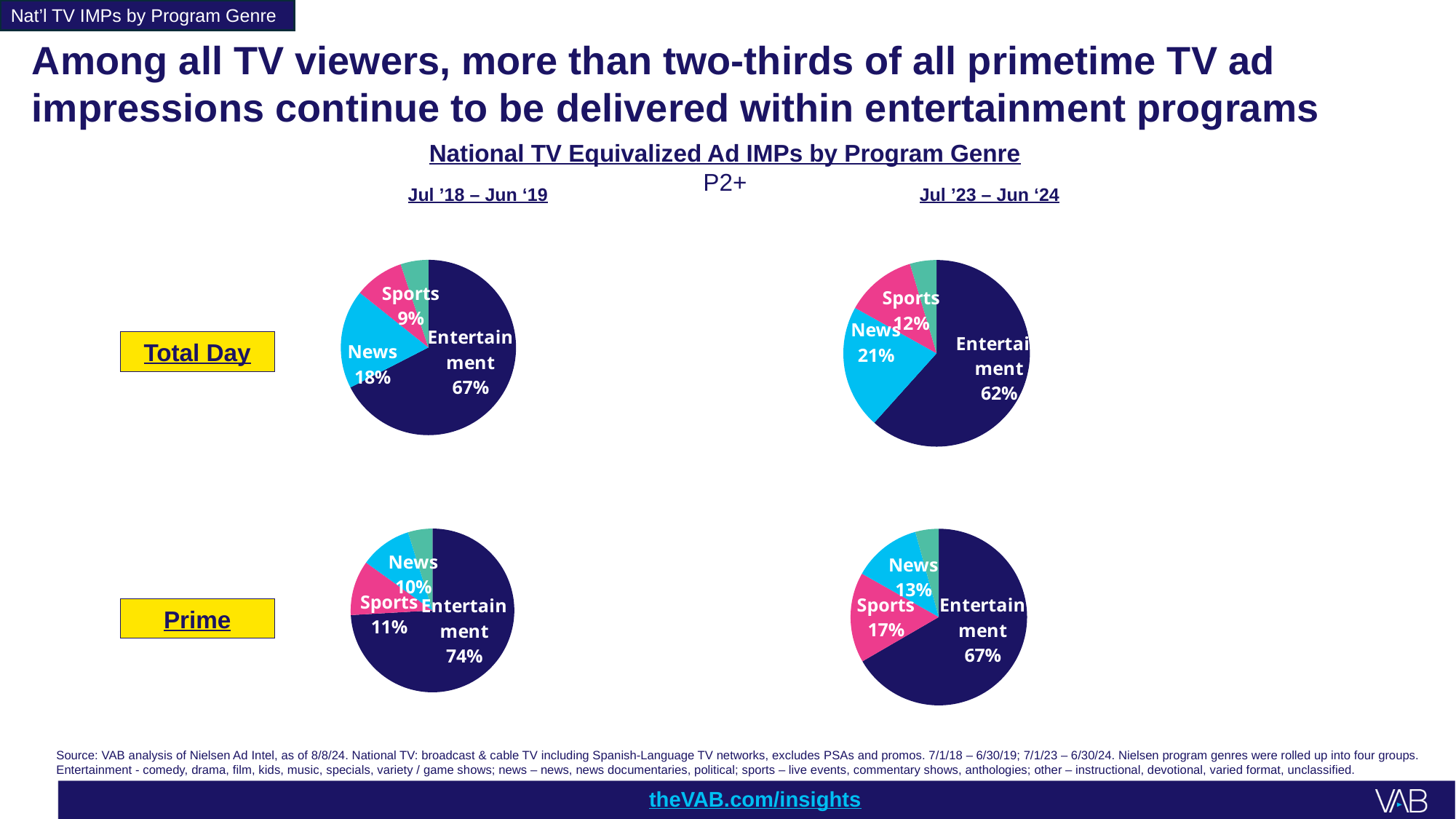
In the Prime pie for Jul '23 – Jun '24, what share is Entertainment? 67% What is the difference between the Sports shares in the Total Day pies for Jul '23 – Jun '24 and Jul '18 – Jun '19? 3 percentage points How many pie charts are shown on the slide? 4 What is the title above the pie charts? National TV Equivalized Ad IMPs by Program Genre In the Total Day pie for Jul '18 – Jun '19, which is larger, News or Sports? News In the Total Day pie for Jul '18 – Jun '19, what share of ad impressions is Entertainment? 67% How much larger is the Entertainment share in the Prime pie for Jul '18 – Jun '19 than in the Prime pie for Jul '23 – Jun '24? 7 percentage points In the Total Day pie for Jul '23 – Jun '24, which genre has the largest share? Entertainment In the Total Day pie for Jul '23 – Jun '24, what share is News? 21% In the Prime pie for Jul '18 – Jun '19, what share is Sports? 11% What type of chart is used on this slide? Pie chart In the Prime pie for Jul '23 – Jun '24, which labeled genre has the smallest share? News